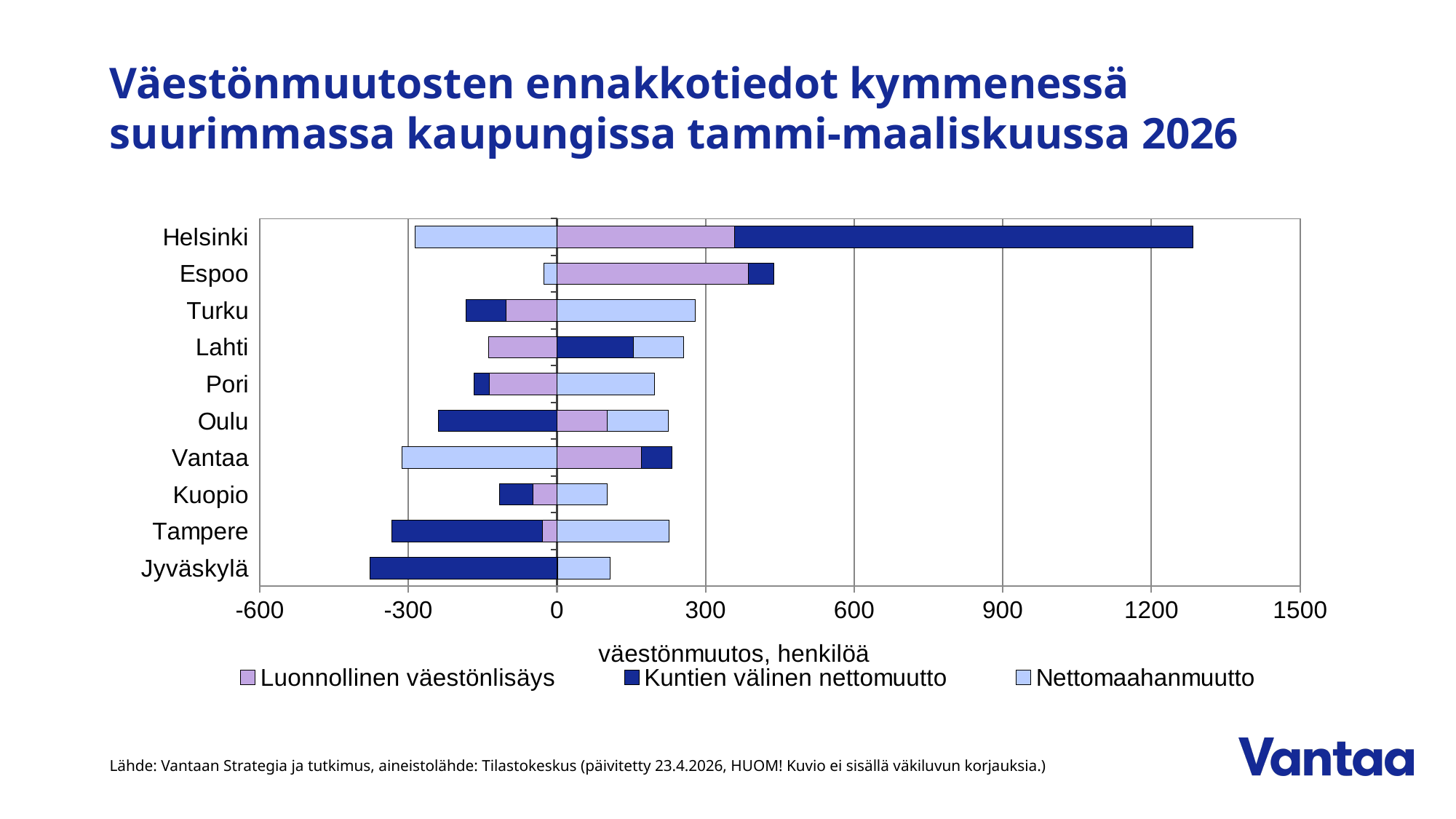
Which city has the largest positive Kuntien välinen nettomuutto segment? Helsinki Is the Kuntien välinen nettomuutto value for Jyväskylä greater or less than -300? less Which city has the largest positive Nettomaahanmuutto segment? Turku What is the title of the horizontal axis of the chart? väestönmuutos, henkilöä How many series does the chart legend list? 3 Is the right end of the Helsinki bar greater or less than 1200? greater What kind of chart is shown on the slide? Stacked bar chart How many cities are listed on the vertical axis of the chart? 10 Which city has the most negative Kuntien välinen nettomuutto segment? Jyväskylä Is the Luonnollinen väestönlisäys value for Espoo greater or less than 300? greater Which is larger, the Kuntien välinen nettomuutto segment for Helsinki or for Espoo? Helsinki Which is larger, the Luonnollinen väestönlisäys segment for Vantaa or for Oulu? Vantaa